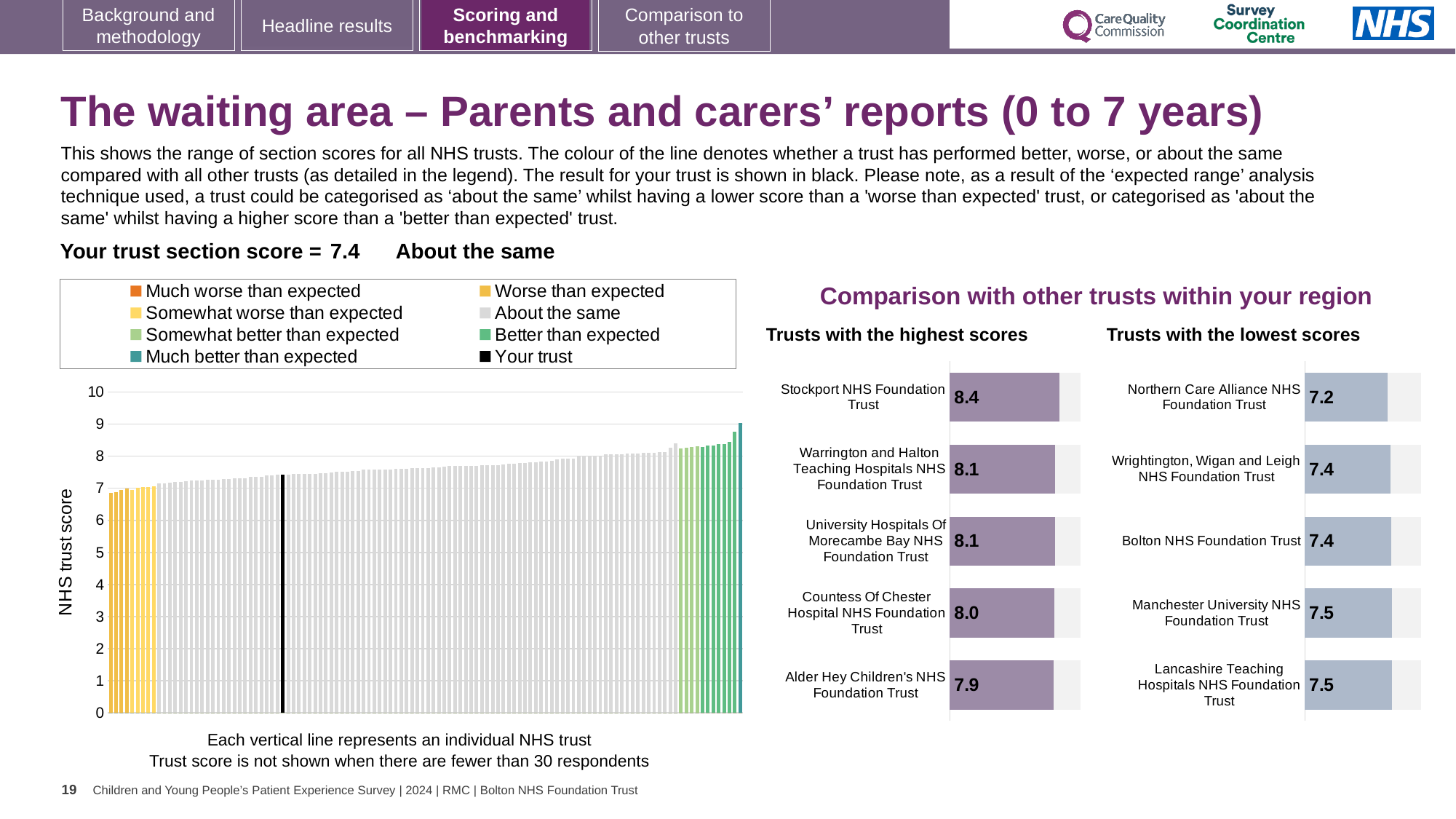
In the 'Trusts with the highest scores' chart, which trust has the highest score? Stockport NHS Foundation Trust How many trusts are shown in the 'Trusts with the lowest scores' chart? 5 In the 'Trusts with the highest scores' chart, what is the difference between the scores of Stockport NHS Foundation Trust and Alder Hey Children's NHS Foundation Trust? 0.5 In the large chart on the left, is the value of the black bar (your trust) greater or less than 5? greater In the 'Trusts with the lowest scores' chart, what is the score for Northern Care Alliance NHS Foundation Trust? 7.2 In the 'Trusts with the lowest scores' chart, which trust has the lowest score? Northern Care Alliance NHS Foundation Trust In the 'Trusts with the highest scores' chart, what is the score for Alder Hey Children's NHS Foundation Trust? 7.9 In the 'Trusts with the lowest scores' chart, what is the score for Manchester University NHS Foundation Trust? 7.5 In the 'Trusts with the highest scores' chart, what is the score for Stockport NHS Foundation Trust? 8.4 How many entries does the legend of the large chart on the left list? 8 What is the y-axis label of the large chart on the left? NHS trust score In the 'Trusts with the highest scores' chart, which has the larger score: Stockport NHS Foundation Trust or Countess Of Chester Hospital NHS Foundation Trust? Stockport NHS Foundation Trust